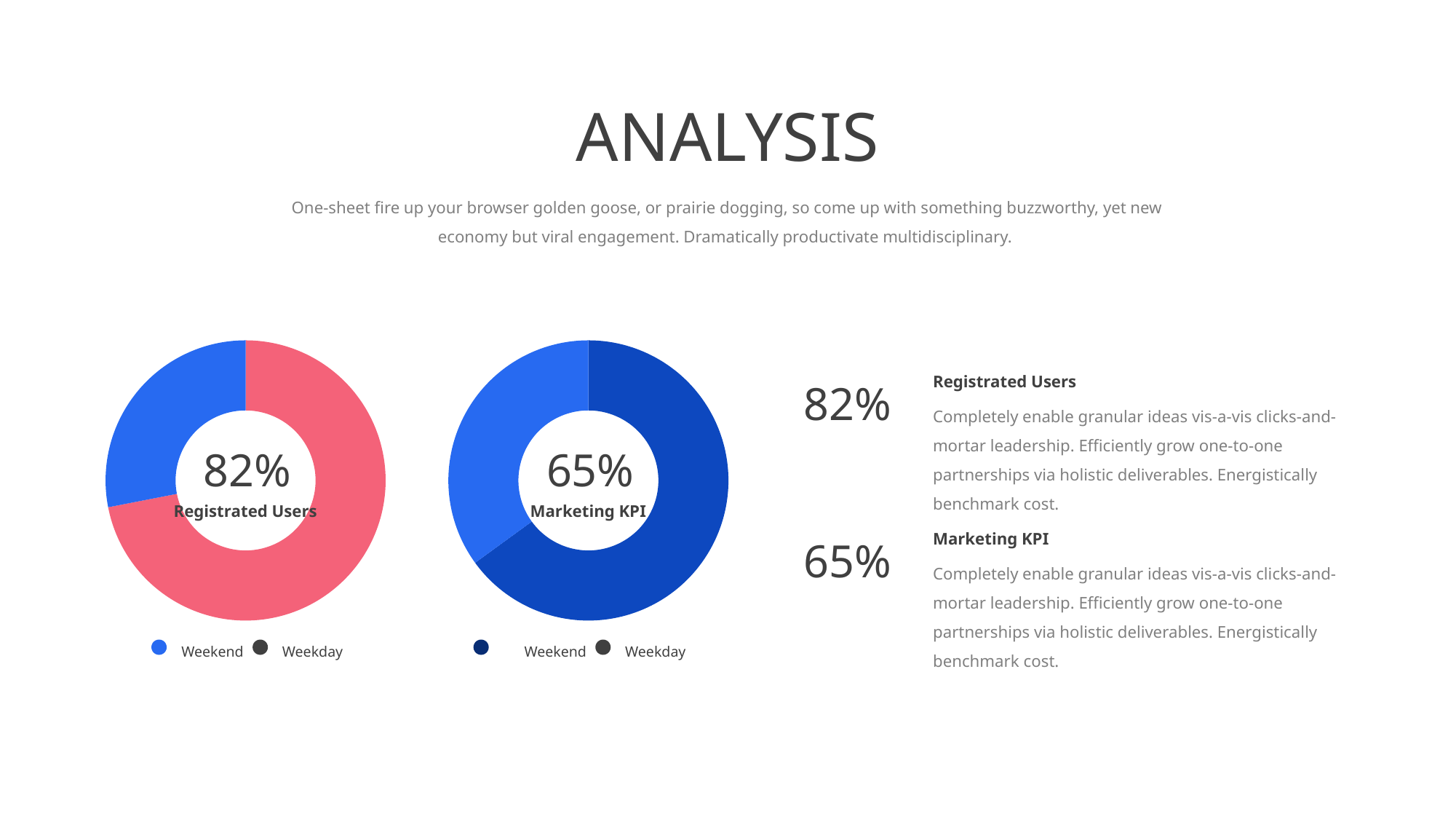
In the Marketing KPI chart, what percentage is printed in the centre of the donut? 65% What label is printed inside the left donut chart below the percentage? Registrated Users How many slices does the Marketing KPI donut chart have? 2 In the Marketing KPI chart, which colour slice is larger, the dark blue one or the light blue one? the dark blue one In the Registrated Users chart, what percentage is printed in the centre of the donut? 82% How many entries does the legend of the Registrated Users chart list? 2 Is the Marketing KPI percentage shown in the centre of its chart greater or less than 50%? greater Which chart shows the higher centre percentage, Registrated Users or Marketing KPI? Registrated Users What is the difference between the Registrated Users percentage and the Marketing KPI percentage? 17 percentage points In the Registrated Users chart, which colour slice is larger, the pink one or the blue one? the pink one What kind of chart is used for Registrated Users on the left of the slide? donut chart What are the two legend entries shown under the Marketing KPI chart? Weekend and Weekday